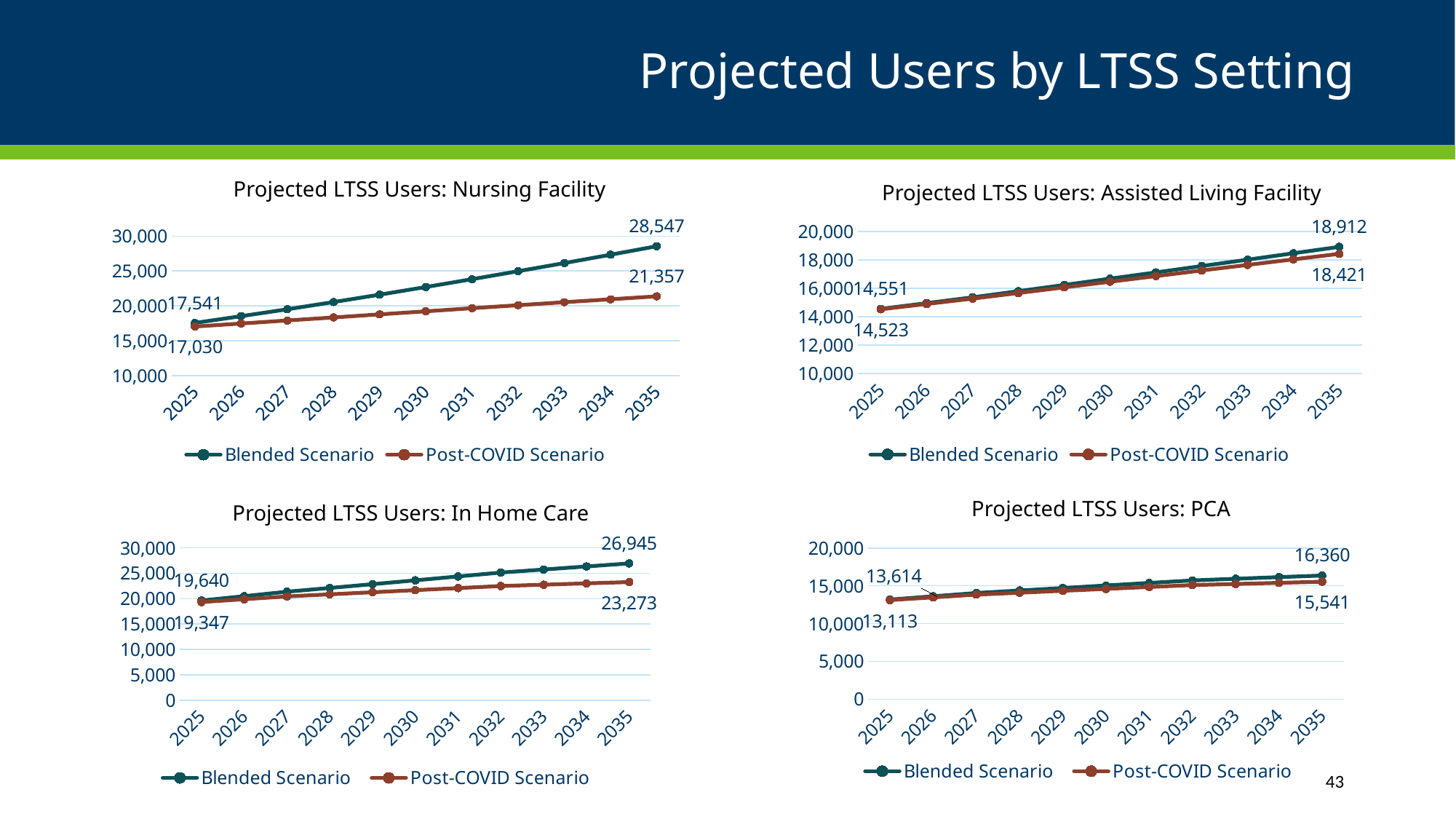
In the Projected LTSS Users: Nursing Facility chart, what is the difference between the Blended Scenario and Post-COVID Scenario values in 2035? 7,190 What kind of chart is the Projected LTSS Users: PCA chart? Line chart In the Projected LTSS Users: PCA chart, what is the Blended Scenario value for 2035? 16,360 In the Projected LTSS Users: Nursing Facility chart, what is the Post-COVID Scenario value for 2025? 17,030 In the Projected LTSS Users: In Home Care chart, what is the difference between the Blended Scenario and Post-COVID Scenario values in 2035? 3,672 In the Projected LTSS Users: In Home Care chart, what is the Blended Scenario value for 2025? 19,640 In the Projected LTSS Users: Nursing Facility chart, is the Blended Scenario value for 2031 greater or less than 20,000? greater How many years are plotted on the x axis of the Projected LTSS Users: Assisted Living Facility chart? 11 In the Projected LTSS Users: PCA chart, which scenario has the higher value in 2035? Blended Scenario How many series does the legend of the Projected LTSS Users: In Home Care chart list? 2 In the Projected LTSS Users: Assisted Living Facility chart, what is the Post-COVID Scenario value for 2035? 18,421 In the Projected LTSS Users: Nursing Facility chart, what is the Blended Scenario value for 2035? 28,547